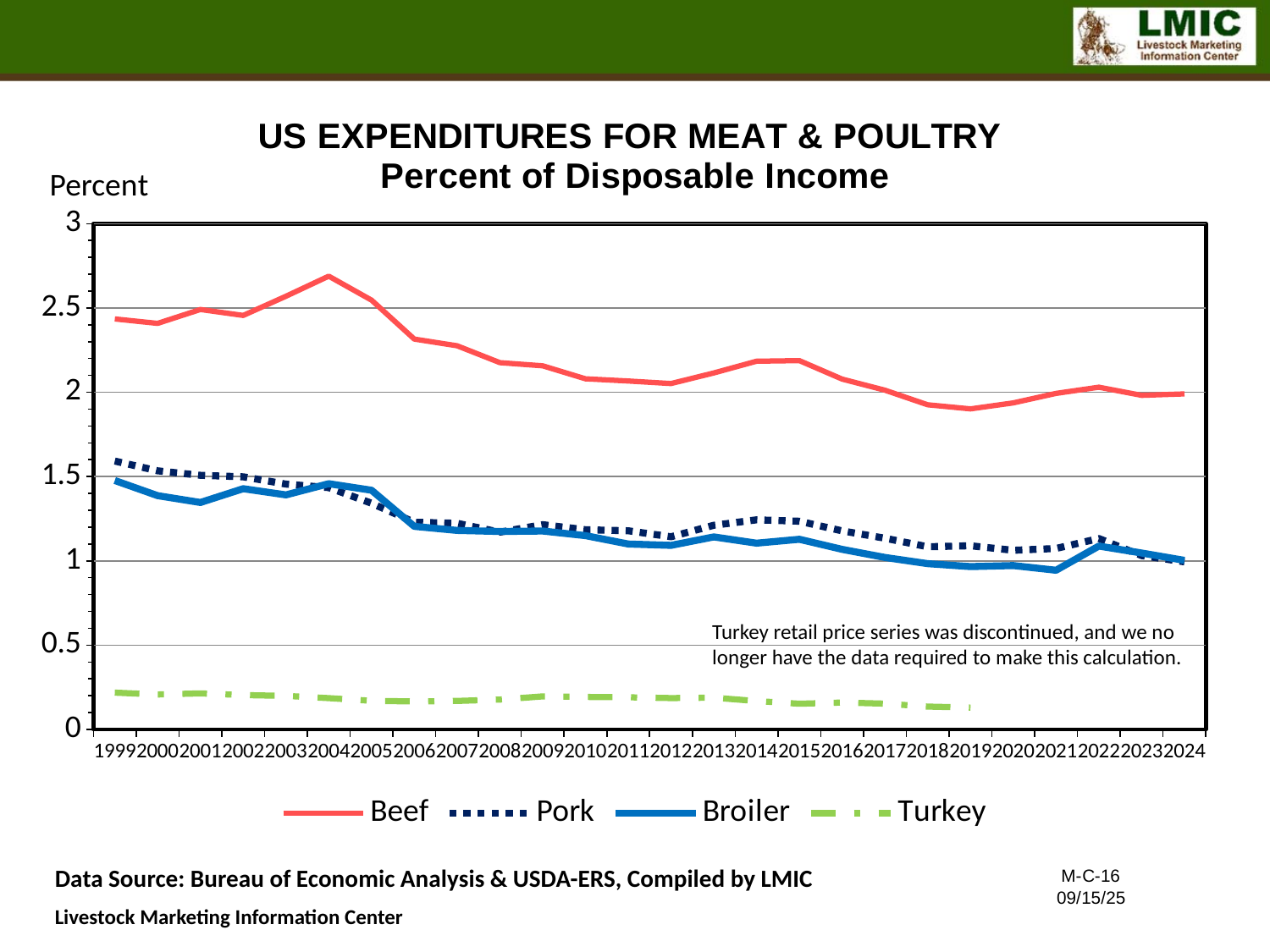
What kind of chart is shown on the slide? line chart Which series has the lowest values throughout the chart? Turkey Which is larger in 2014, Pork or Broiler? Pork How many series does the legend list? 4 Is the value for Beef in 2019 greater or less than 2? less Which series has the highest values throughout the chart? Beef Is the value for Pork in 1999 greater or less than 1.5? greater How many years are shown on the x axis? 26 Does the Beef series generally rise or fall from 1999 to 2024? fall Is the value for Beef in 2004 greater or less than 2.5? greater What is the title of the chart? US EXPENDITURES FOR MEAT & POULTRY Percent of Disposable Income